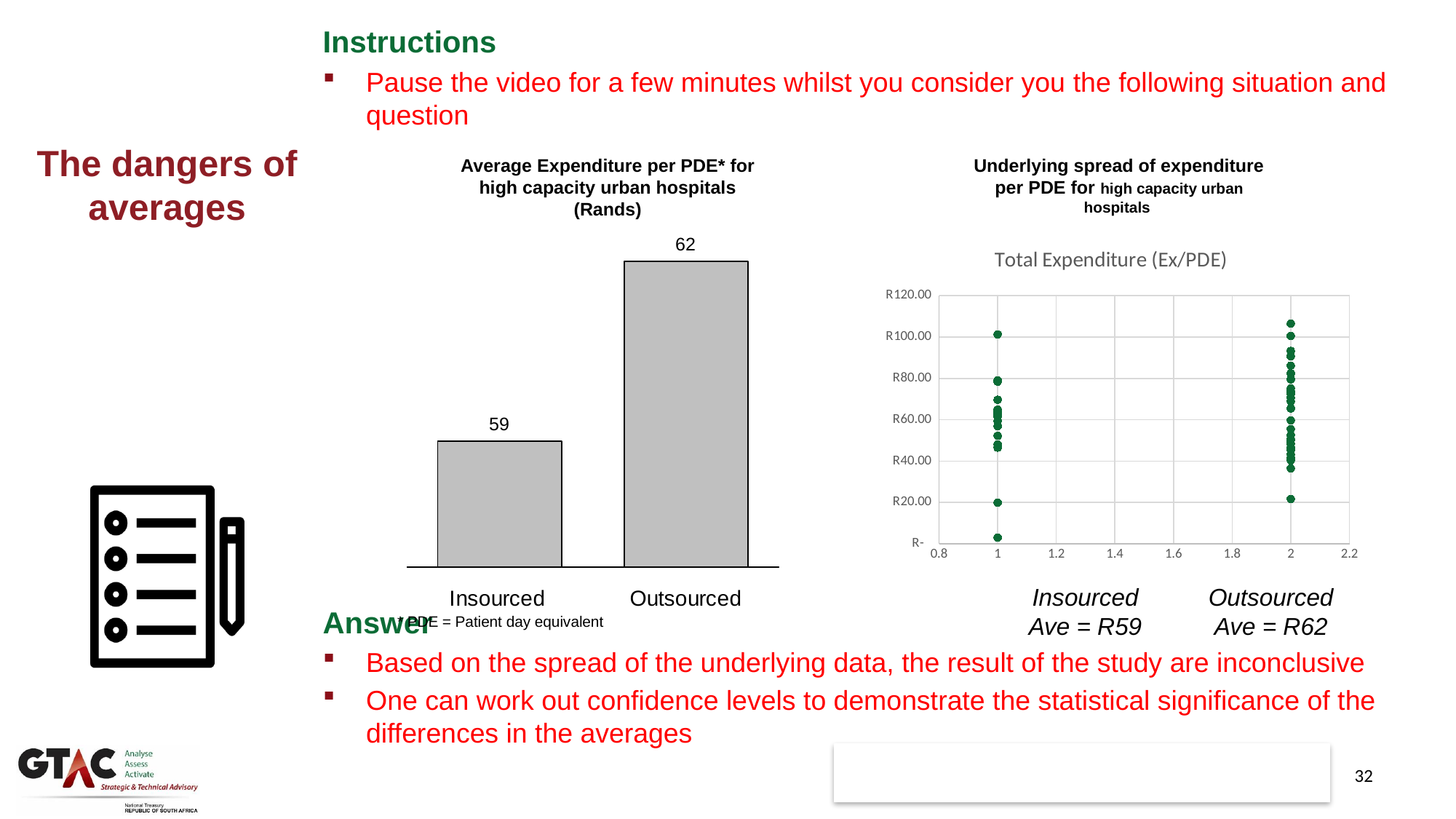
In the bar chart on the left, which category has the higher average expenditure per PDE? Outsourced In the scatter chart on the right, is the lowest Insourced point greater or less than R20.00? less In the bar chart on the left, what is the difference between the Outsourced and Insourced values? 3 How many categories are shown in the bar chart on the left? 2 In the bar chart titled 'Average Expenditure per PDE* for high capacity urban hospitals (Rands)', what is the value for Outsourced? 62 In the scatter chart on the right, what is the highest value shown on the vertical axis? R120.00 What kind of chart is the chart on the right titled 'Total Expenditure (Ex/PDE)'? scatter chart What kind of chart is the chart on the left of the slide? bar chart In the bar chart on the left, is the value for Insourced larger or smaller than the value for Outsourced? smaller In the scatter chart on the right, is the highest Outsourced point greater or less than R100.00? greater In the bar chart on the left, which category has the lower average expenditure per PDE? Insourced In the bar chart titled 'Average Expenditure per PDE* for high capacity urban hospitals (Rands)', what is the value for Insourced? 59